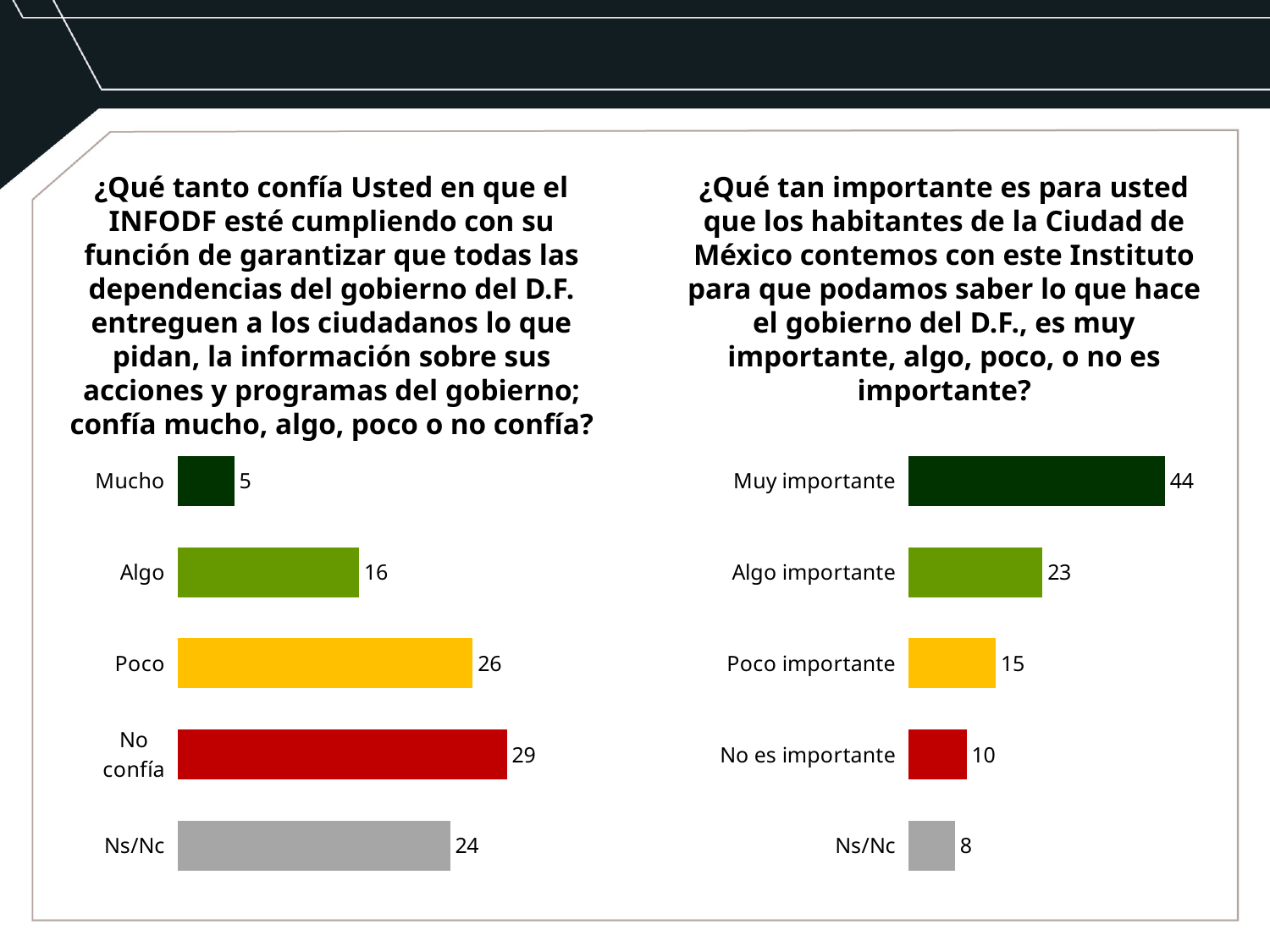
In the left chart (about confidence in INFODF), how many categories are shown? 5 In the right chart (about the importance of the Institute), what is the value for "Algo importante"? 23 In the left chart (about confidence in INFODF), what is the value for "Poco"? 26 What kind of chart is the right chart (about the importance of the Institute)? Bar chart In the left chart (about confidence in INFODF), which category has the lowest value? Mucho In the left chart (about confidence in INFODF), what colour is the bar for "No confía"? Red In the right chart (about the importance of the Institute), which category has the highest value? Muy importante In the right chart (about the importance of the Institute), what is the difference between "Muy importante" and "Algo importante"? 21 In the left chart (about confidence in INFODF), what is the difference between "No confía" and "Algo"? 13 In the left chart (about confidence in INFODF), which category has the highest value? No confía In the right chart (about the importance of the Institute), which category has the lowest value? Ns/Nc In the right chart (about the importance of the Institute), which is larger: "Poco importante" or "No es importante"? Poco importante